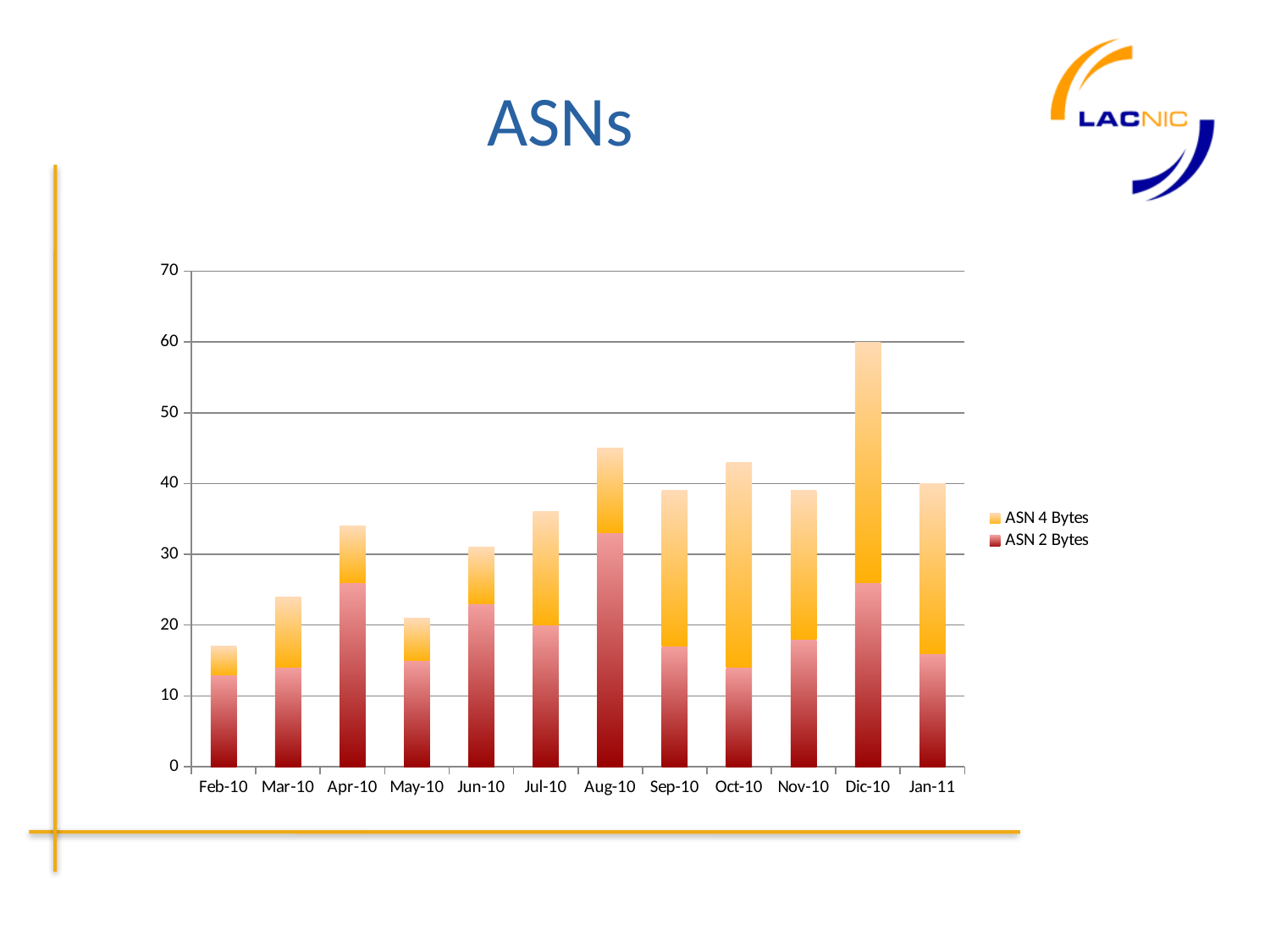
Which is larger, the total for Oct-10 or the total for Nov-10? Oct-10 Is the ASN 2 Bytes value for Aug-10 greater or less than 30? greater How many months are shown on the x axis? 12 How many series does the legend list? 2 What kind of chart is shown on the slide? Stacked bar chart Is the total for May-10 greater or less than 30? less Which month has the shortest stacked bar? Feb-10 Which month has the tallest stacked bar? Dic-10 What are the two series named in the legend? ASN 4 Bytes and ASN 2 Bytes What is the total height of the stacked bar for Dic-10? 60 Which month has the largest ASN 2 Bytes segment? Aug-10 Is the total for Aug-10 greater or less than 40? greater